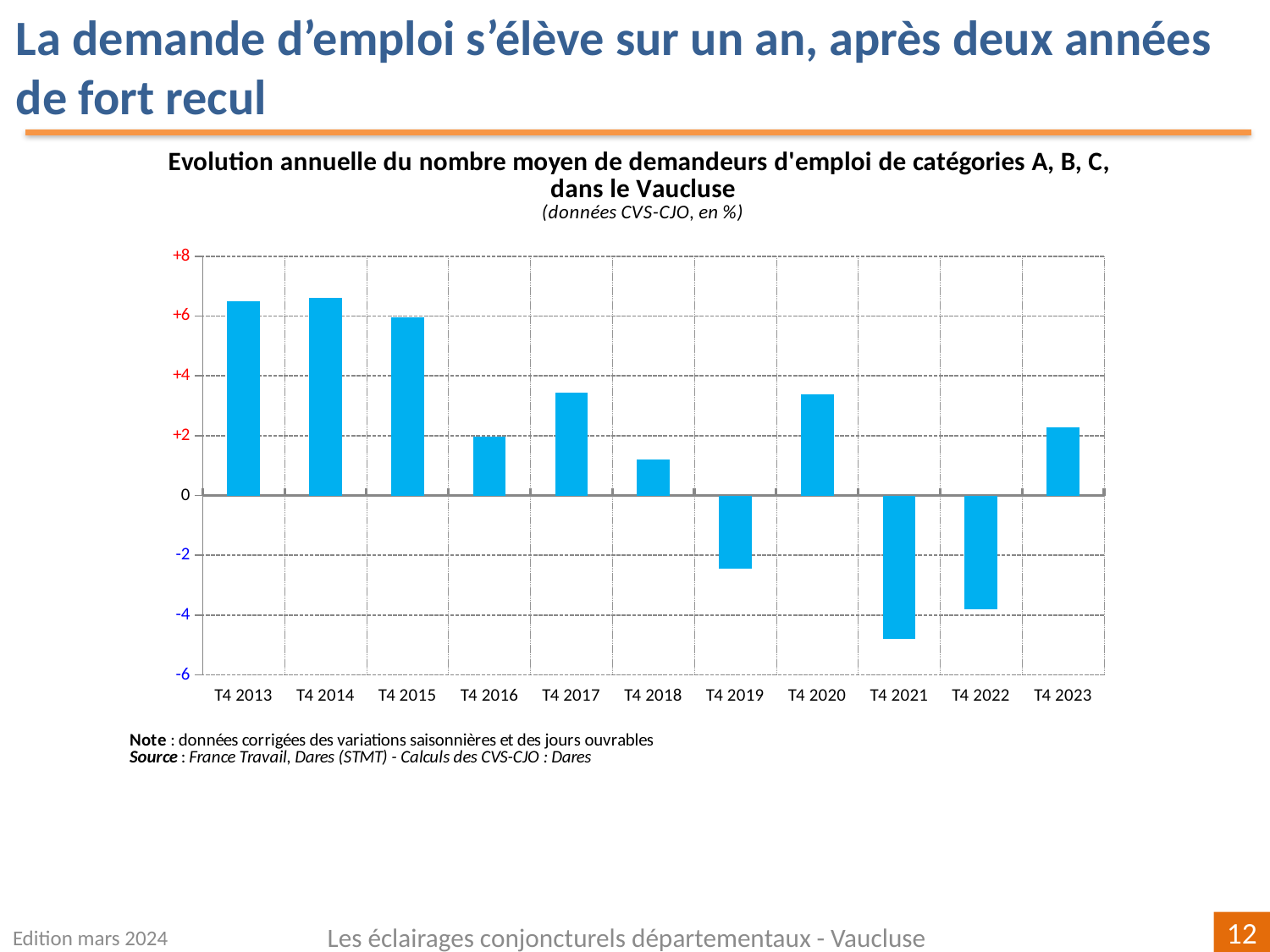
Is the value for T4 2018 greater or less than +2? less Is the value for T4 2019 greater or less than 0? less Which is larger, the value for T4 2013 or the value for T4 2016? T4 2013 What unit are the data expressed in, according to the chart subtitle? % Is the value for T4 2021 greater or less than -4? less What kind of chart is shown on the slide? bar chart Which quarter has the lowest value? T4 2021 How many quarters (categories) are plotted on the x axis? 11 How many quarters show a negative value? 3 Which is larger, the value for T4 2019 or the value for T4 2021? T4 2019